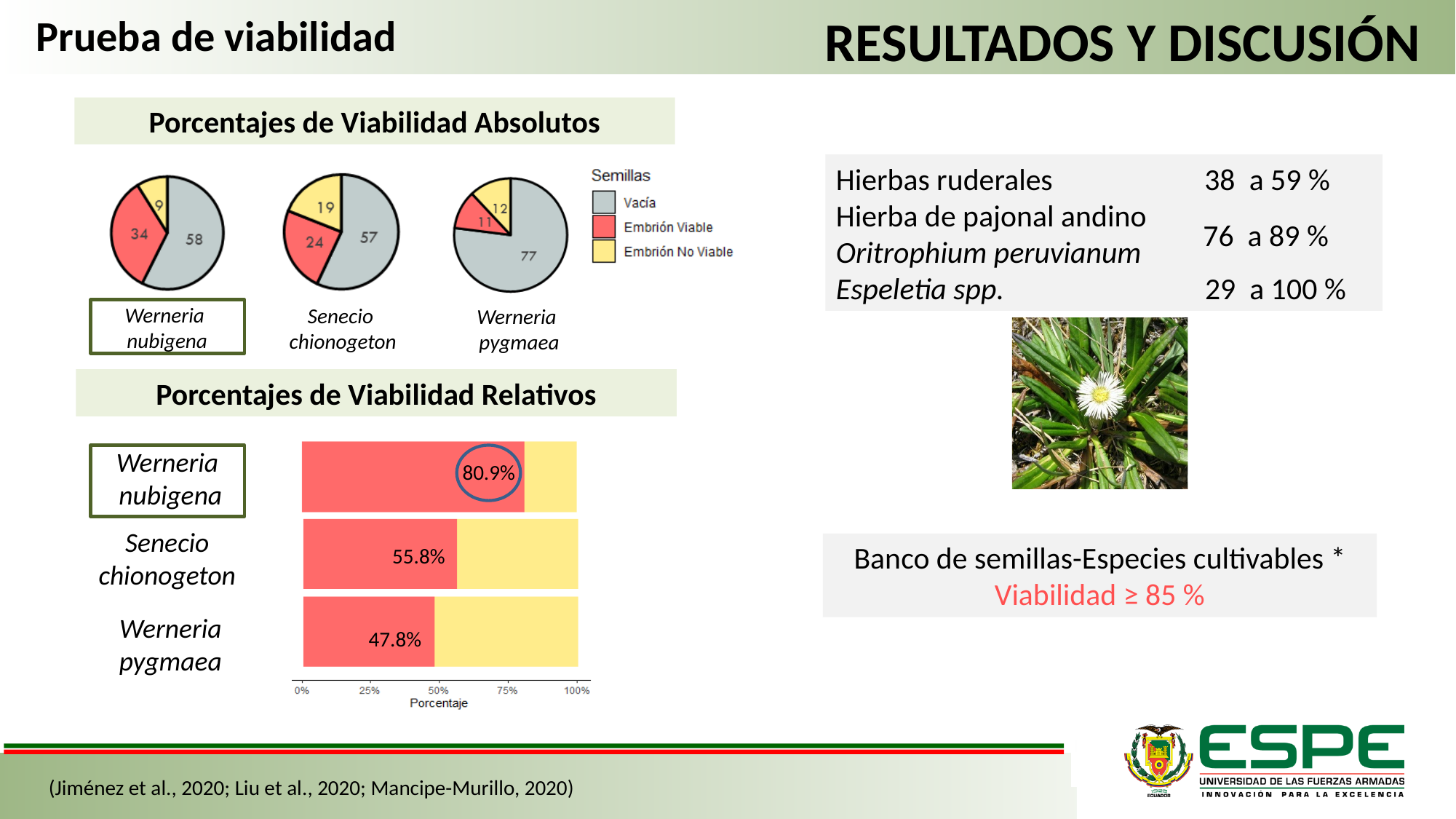
In the 'Porcentajes de Viabilidad Relativos' bar chart, which species has the highest labelled value? Werneria nubigena In the 'Porcentajes de Viabilidad Absolutos' pie charts, what is the value of the Vacía slice for Werneria nubigena? 58 In the 'Porcentajes de Viabilidad Absolutos' pie charts, what is the value of the Embrión Viable slice for Senecio chionogeton? 24 In the 'Porcentajes de Viabilidad Absolutos' pie charts, what is the difference between the Vacía and Embrión Viable values for Werneria nubigena? 24 In the 'Porcentajes de Viabilidad Relativos' bar chart, what is the labelled value for Werneria nubigena? 80.9% In the 'Porcentajes de Viabilidad Absolutos' pie charts, which species has the smallest Embrión Viable slice? Werneria pygmaea In the 'Porcentajes de Viabilidad Absolutos' pie charts, which species has the largest Vacía slice? Werneria pygmaea In the 'Porcentajes de Viabilidad Relativos' bar chart, what is the labelled value for Werneria pygmaea? 47.8% In the 'Porcentajes de Viabilidad Relativos' bar chart, is the labelled value for Senecio chionogeton greater or less than 50%? greater In the 'Porcentajes de Viabilidad Absolutos' pie charts, what is the value of the Embrión No Viable slice for Werneria pygmaea? 12 How many categories does the legend of the 'Porcentajes de Viabilidad Absolutos' pie charts list? 3 What type of chart is used in 'Porcentajes de Viabilidad Relativos'? Bar chart